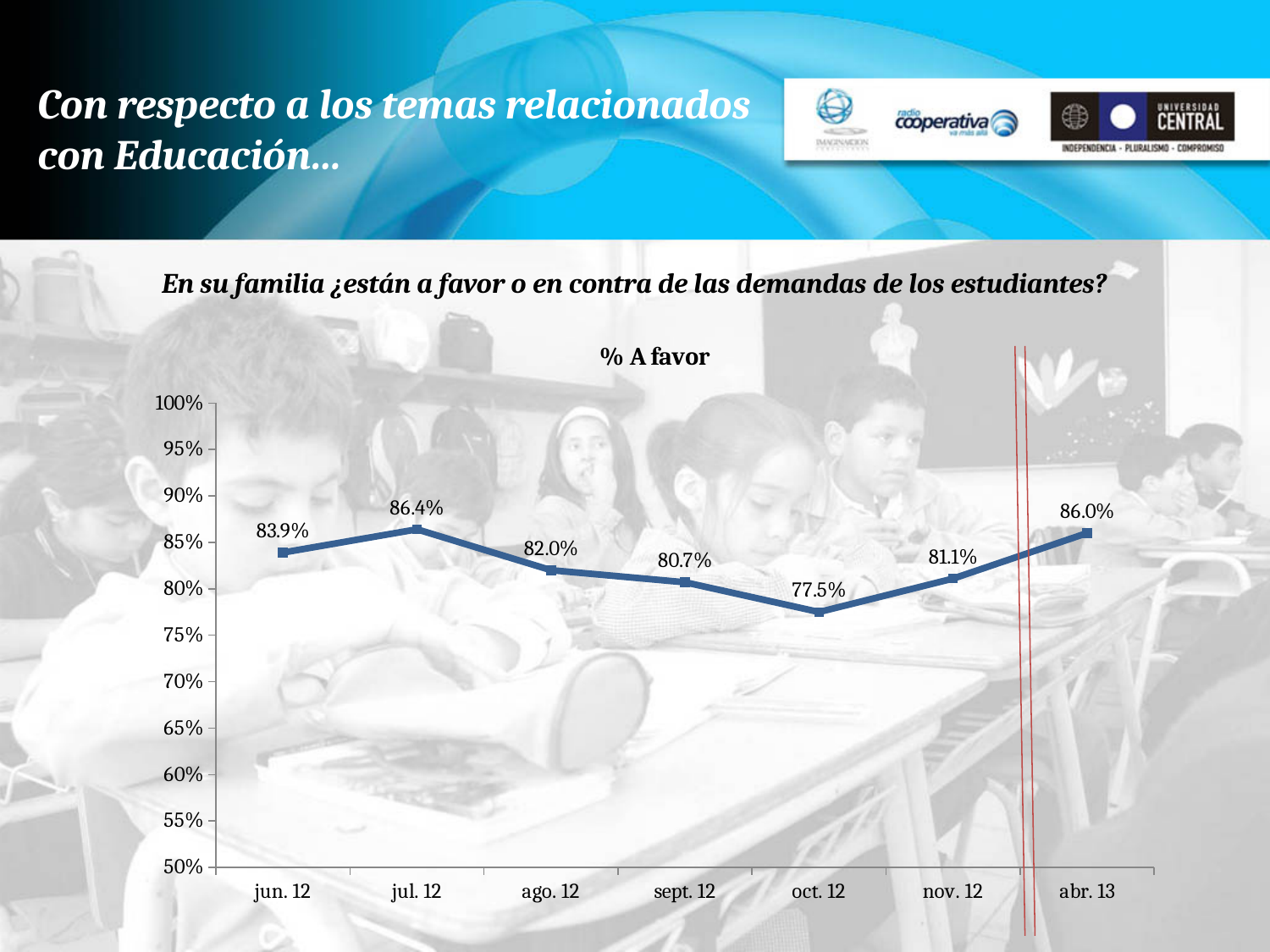
What is the value for abr. 13? 86.0% What kind of chart is shown? line chart Which month has the lowest value? oct. 12 How many data points are plotted on the chart? 7 Is the value for nov. 12 greater or less than 85%? less Which is larger, the value for jun. 12 or the value for ago. 12? jun. 12 What is the value for oct. 12? 77.5% What is the value for jul. 12? 86.4% What is the title of the chart? % A favor Which month has the highest value? jul. 12 Do the values rise or fall from jul. 12 to oct. 12? fall What is the difference between the values for jul. 12 and oct. 12? 8.9%